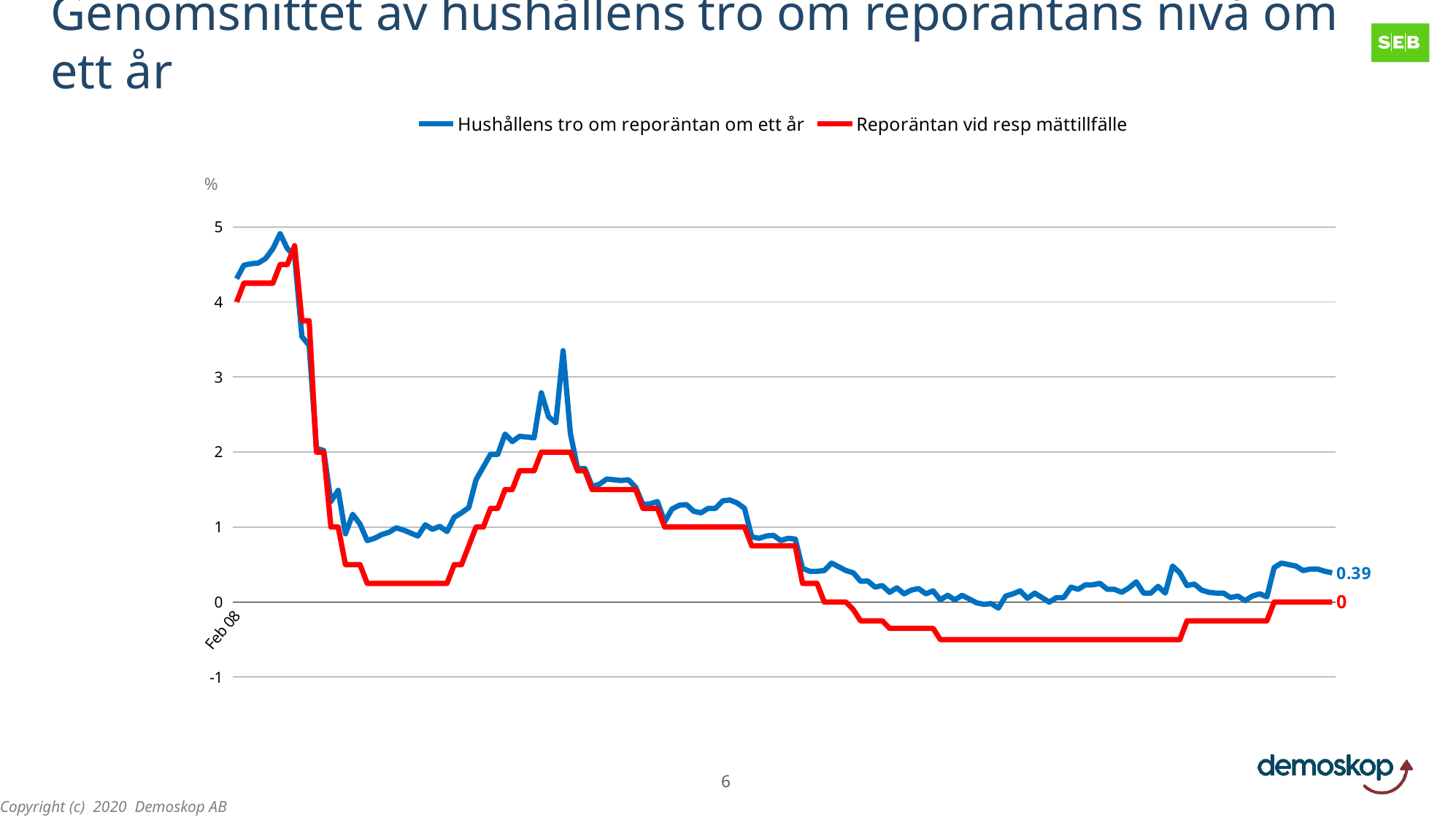
What unit is shown on the y axis of the chart? % What is the difference between the final labelled values of the two series (0.39 and 0)? 0.39 Overall, do the values of the blue series rise or fall from left to right along the x axis? Fall What kind of chart is shown on the slide? Line chart What is the first x-axis label shown on the chart? Feb 08 Is the value of the red series at its lowest point greater or less than -1? greater How many series does the legend list? 2 What is the final labelled value of the series 'Hushållens tro om reporäntan om ett år'? 0.39 What is the final labelled value of the series 'Reporäntan vid resp mättillfälle'? 0 Is the lowest value reached by the red series greater or less than 0? less Is the highest value reached by the blue series greater or less than 4? greater At the right end of the chart, which series has the higher labelled value? Hushållens tro om reporäntan om ett år